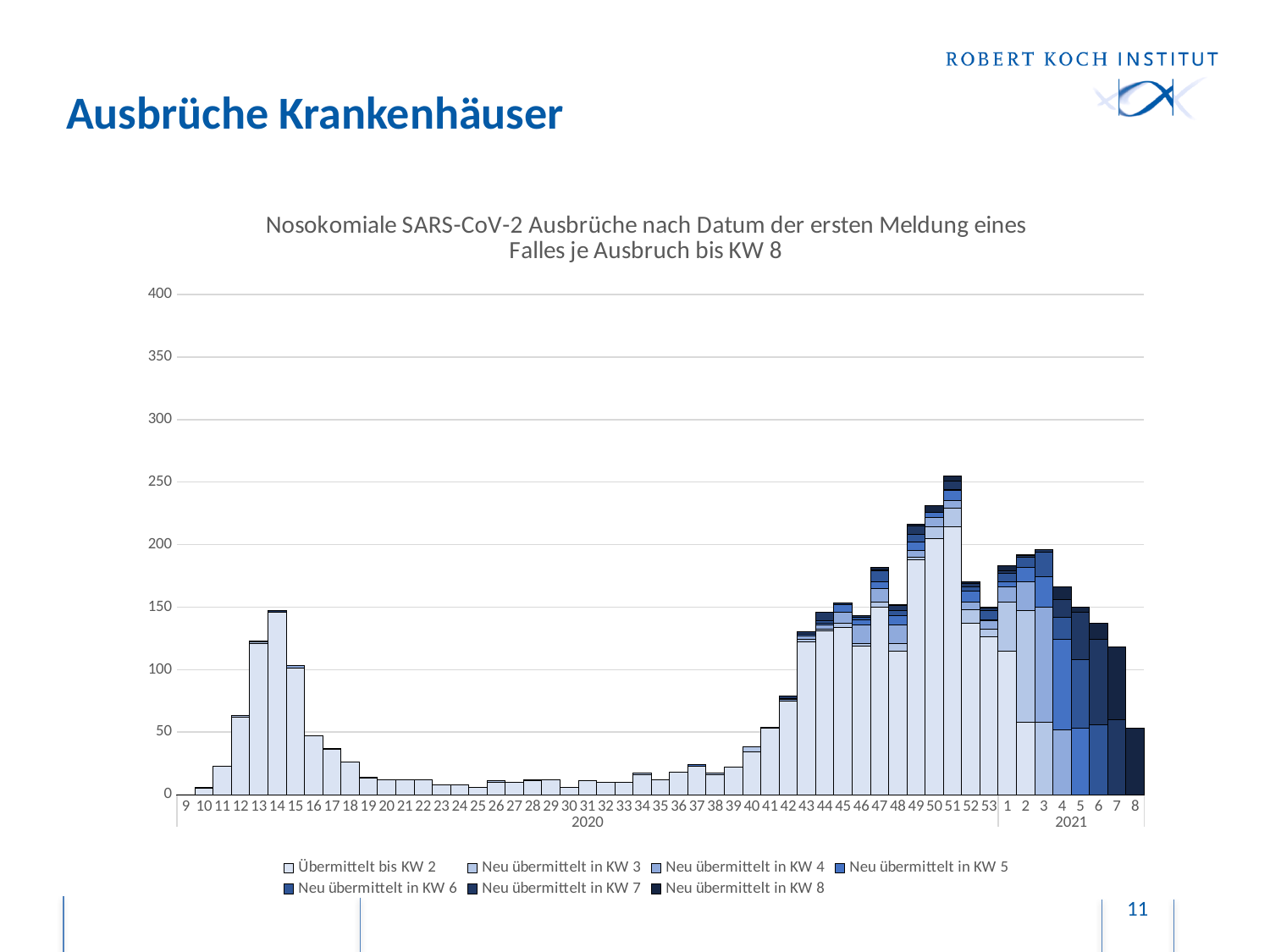
Is the total for KW 51 2020 greater or less than 200? greater Is the total for KW 40 2020 greater or less than 50? less How many weekly bars are plotted in the chart? 53 What is the first legend entry of the chart? Übermittelt bis KW 2 Is the total for KW 7 2021 greater or less than 100? greater Which bar is taller, KW 47 2020 or KW 48 2020? KW 47 2020 What kind of chart is shown on the slide? stacked bar chart Which bar is taller, KW 14 2020 or KW 51 2020? KW 51 2020 Which week has the highest total bar? KW 51 2020 Do the bar totals rise or fall from KW 9 to KW 14 of 2020? rise How many series does the legend list? 7